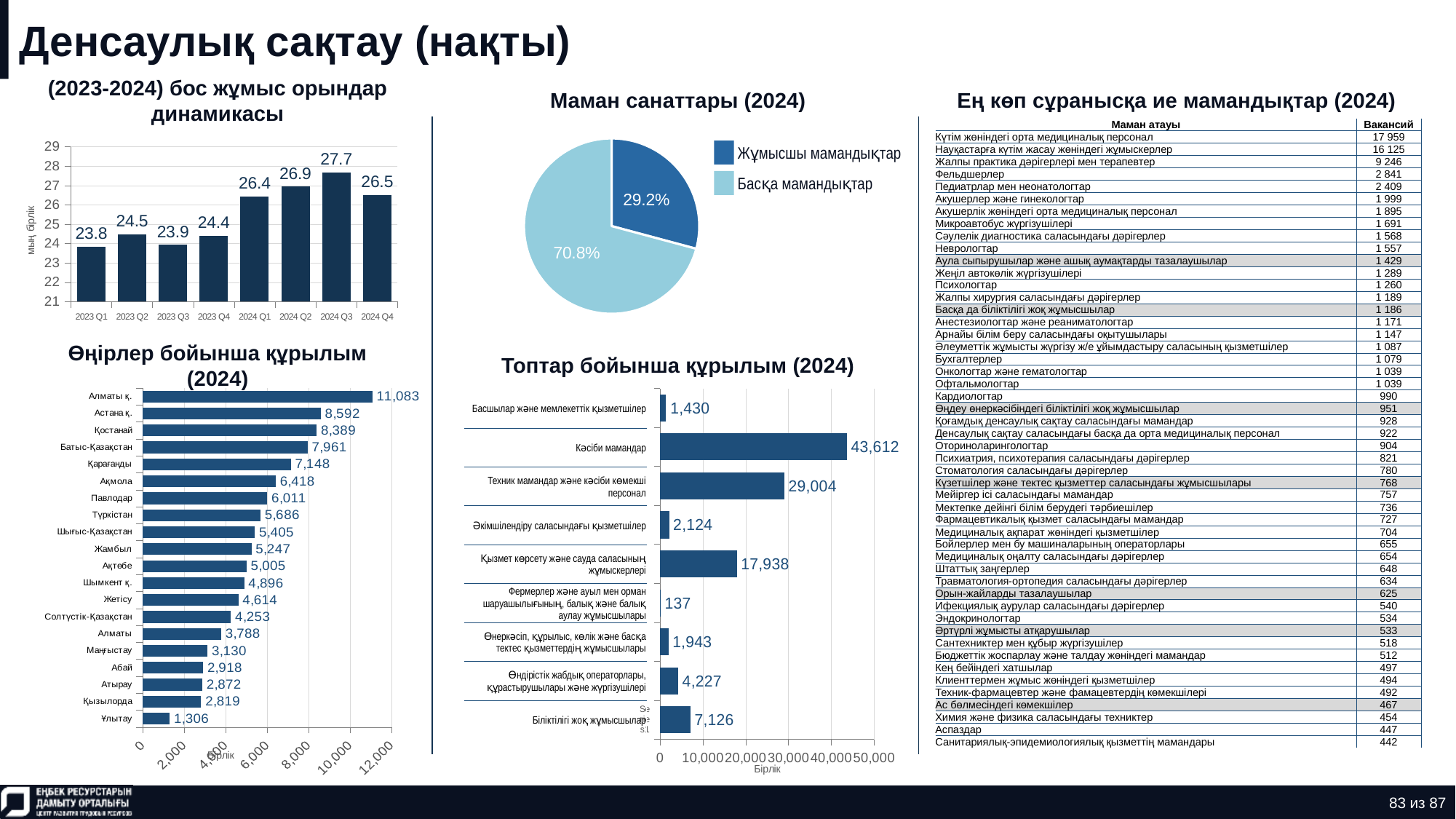
In the chart 'Өңірлер бойынша құрылым (2024)', what is the value for Қарағанды? 7,148 In the chart 'Топтар бойынша құрылым (2024)', what is the value for 'Кәсіби мамандар'? 43,612 In the chart 'Өңірлер бойынша құрылым (2024)', which region has the highest value? Алматы қ. In the chart '(2023-2024) бос жұмыс орындар динамикасы', what is the value for 2024 Q3? 27.7 In the chart 'Өңірлер бойынша құрылым (2024)', how many regions are shown? 20 In the pie chart 'Маман санаттары (2024)', what share is 'Жұмысшы мамандықтар'? 29.2% In the pie chart 'Маман санаттары (2024)', how many entries does the legend list? 2 In the chart '(2023-2024) бос жұмыс орындар динамикасы', which quarter has the lowest value? 2023 Q1 In the chart '(2023-2024) бос жұмыс орындар динамикасы', what is the difference between 2024 Q2 and 2023 Q2? 2.4 What kind of chart is 'Топтар бойынша құрылым (2024)'? Bar chart In the chart 'Топтар бойынша құрылым (2024)', which is larger: 'Біліктілігі жоқ жұмысшылар' or 'Өндірістік жабдық операторлары, құрастырушылары және жүргізушілері'? Біліктілігі жоқ жұмысшылар In the chart '(2023-2024) бос жұмыс орындар динамикасы', how many quarters are plotted? 8